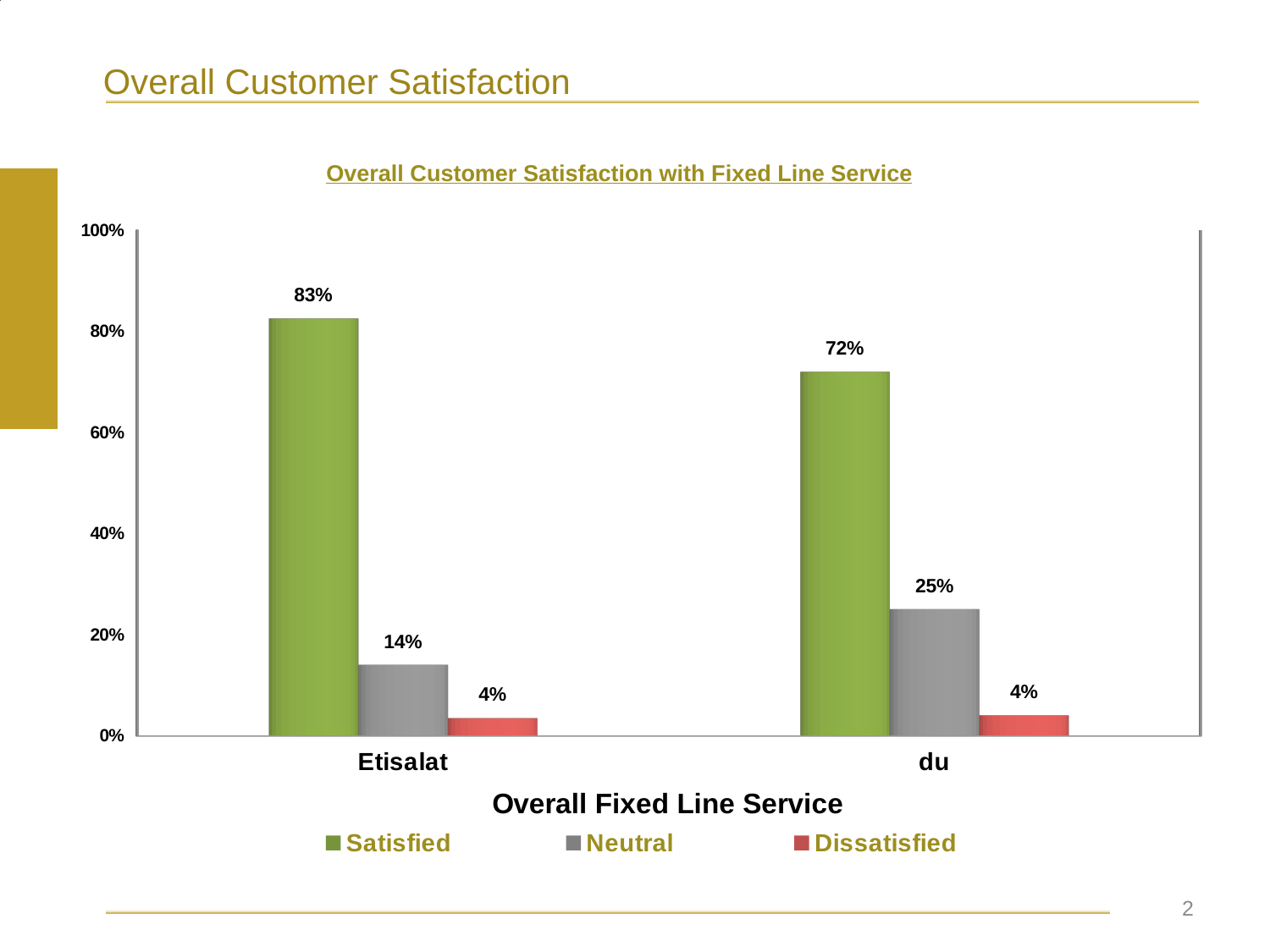
What is the difference between the Satisfied percentages for Etisalat and du? 11% Which series has the lowest value for du? Dissatisfied What kind of chart is shown on the slide? Bar chart What is the Neutral value for Etisalat? 14% Which provider has the higher Satisfied percentage? Etisalat What is the difference between the Neutral percentages for du and Etisalat? 11% What is the title of the chart? Overall Customer Satisfaction with Fixed Line Service What percentage of du customers are Neutral? 25% How many series does the legend list? 3 What percentage of Etisalat customers are Satisfied with fixed line service? 83% What percentage of du customers are Dissatisfied? 4% How many providers are shown on the x axis? 2